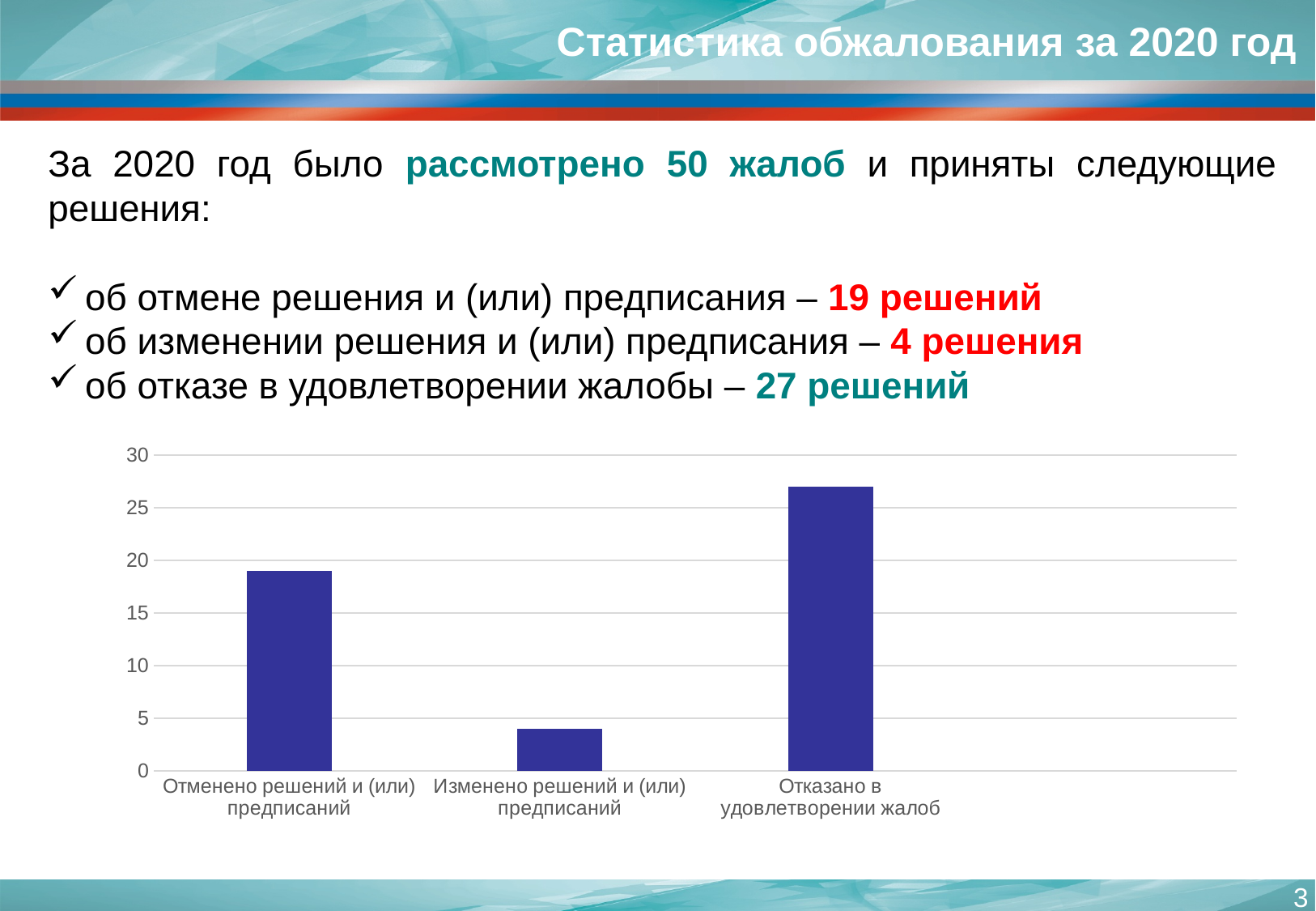
What is the highest value shown on the vertical axis of the chart? 30 What is the value for "Изменено решений и (или) предписаний"? 4 What kind of chart is shown on the slide? bar chart Which category has the highest bar in the chart? Отказано в удовлетворении жалоб What is the value for "Отказано в удовлетворении жалоб"? 27 What is the difference between the values for "Отказано в удовлетворении жалоб" and "Отменено решений и (или) предписаний"? 8 Which is larger: the bar for "Отменено решений и (или) предписаний" or the bar for "Отказано в удовлетворении жалоб"? Отказано в удовлетворении жалоб Is the value for "Отказано в удовлетворении жалоб" greater or less than 25? greater What is the value for "Отменено решений и (или) предписаний"? 19 Which category has the lowest bar in the chart? Изменено решений и (или) предписаний Is the value for "Изменено решений и (или) предписаний" greater or less than 5? less How many categories does the chart show? 3